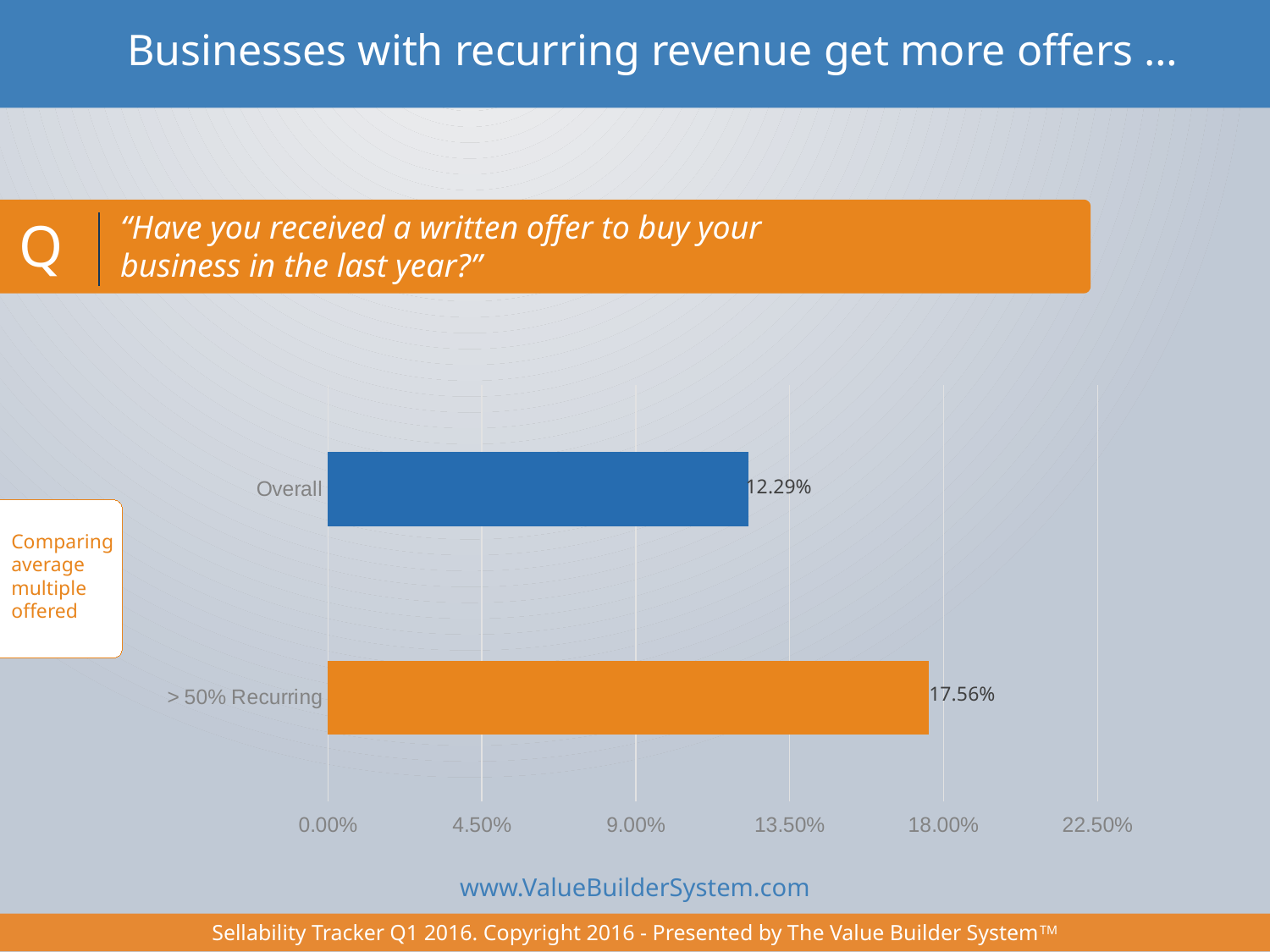
What kind of chart is shown on the slide? bar chart Which category has the highest value? > 50% Recurring Is the value for Overall greater or less than 13.50%? less What is the highest value shown on the x axis? 22.50% What colour is the bar for > 50% Recurring? orange How many categories are shown in the chart? 2 Which category has the lowest value? Overall Is the value for > 50% Recurring greater or less than 13.50%? greater Which is larger, the value for Overall or the value for > 50% Recurring? > 50% Recurring What is the difference between the values for > 50% Recurring and Overall? 5.27% What is the value for > 50% Recurring? 17.56% What is the value for Overall? 12.29%